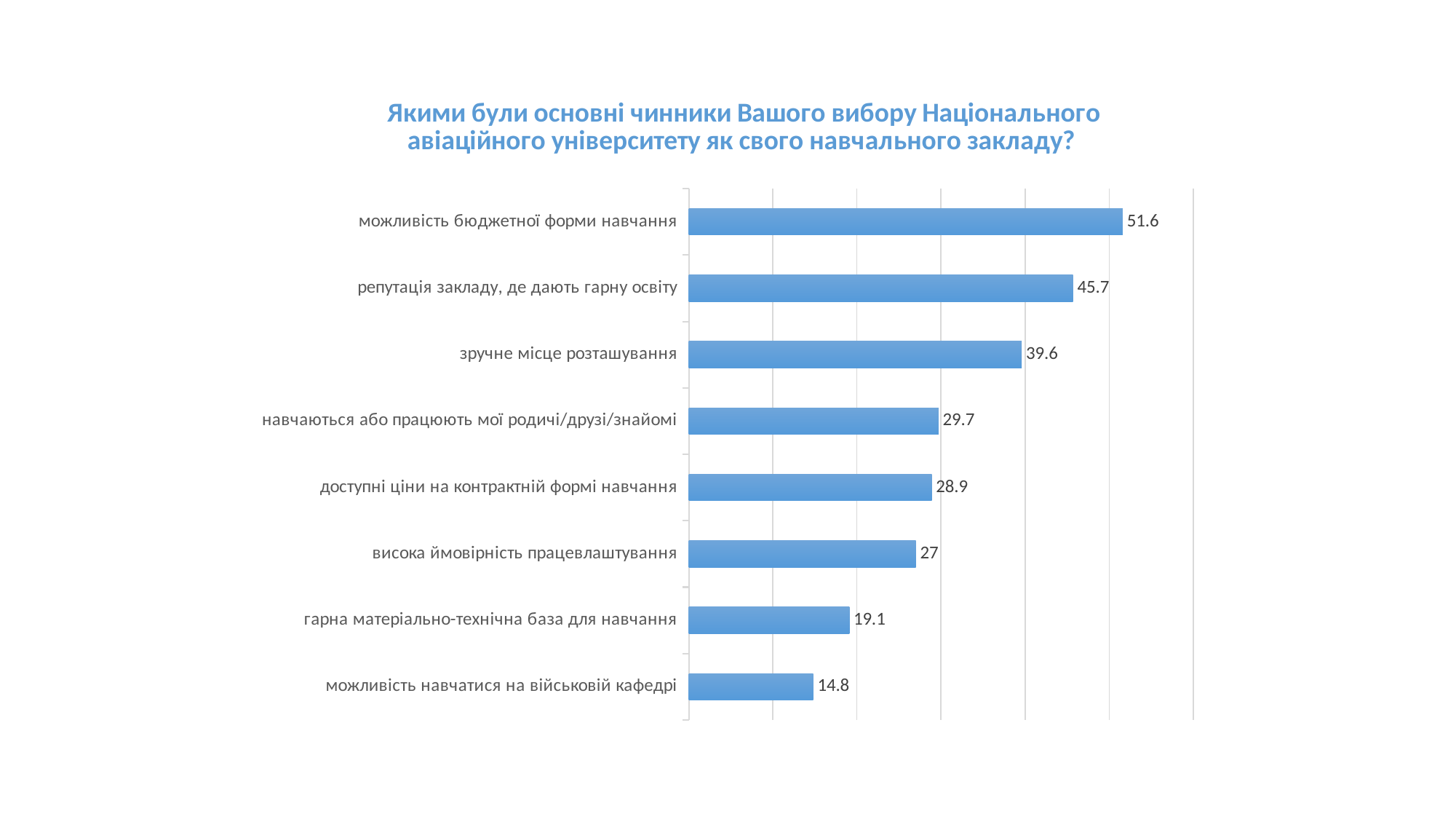
Which category has the highest value? можливість бюджетної форми навчання What kind of chart is shown on the slide? bar chart Which category has the lowest value? можливість навчатися на військовій кафедрі What value is shown for "можливість бюджетної форми навчання"? 51.6 What value is shown for "зручне місце розташування"? 39.6 How many categories are shown in the chart? 8 What value is shown for "висока ймовірність працевлаштування"? 27 What value is shown for "гарна матеріально-технічна база для навчання"? 19.1 What is the difference between the values for "можливість бюджетної форми навчання" and "репутація закладу, де дають гарну освіту"? 5.9 Which is larger: the value for "репутація закладу, де дають гарну освіту" or the value for "доступні ціни на контрактній формі навчання"? репутація закладу, де дають гарну освіту What is the difference between the values for "зручне місце розташування" and "навчаються або працюють мої родичі/друзі/знайомі"? 9.9 What colour are the bars in the chart? blue